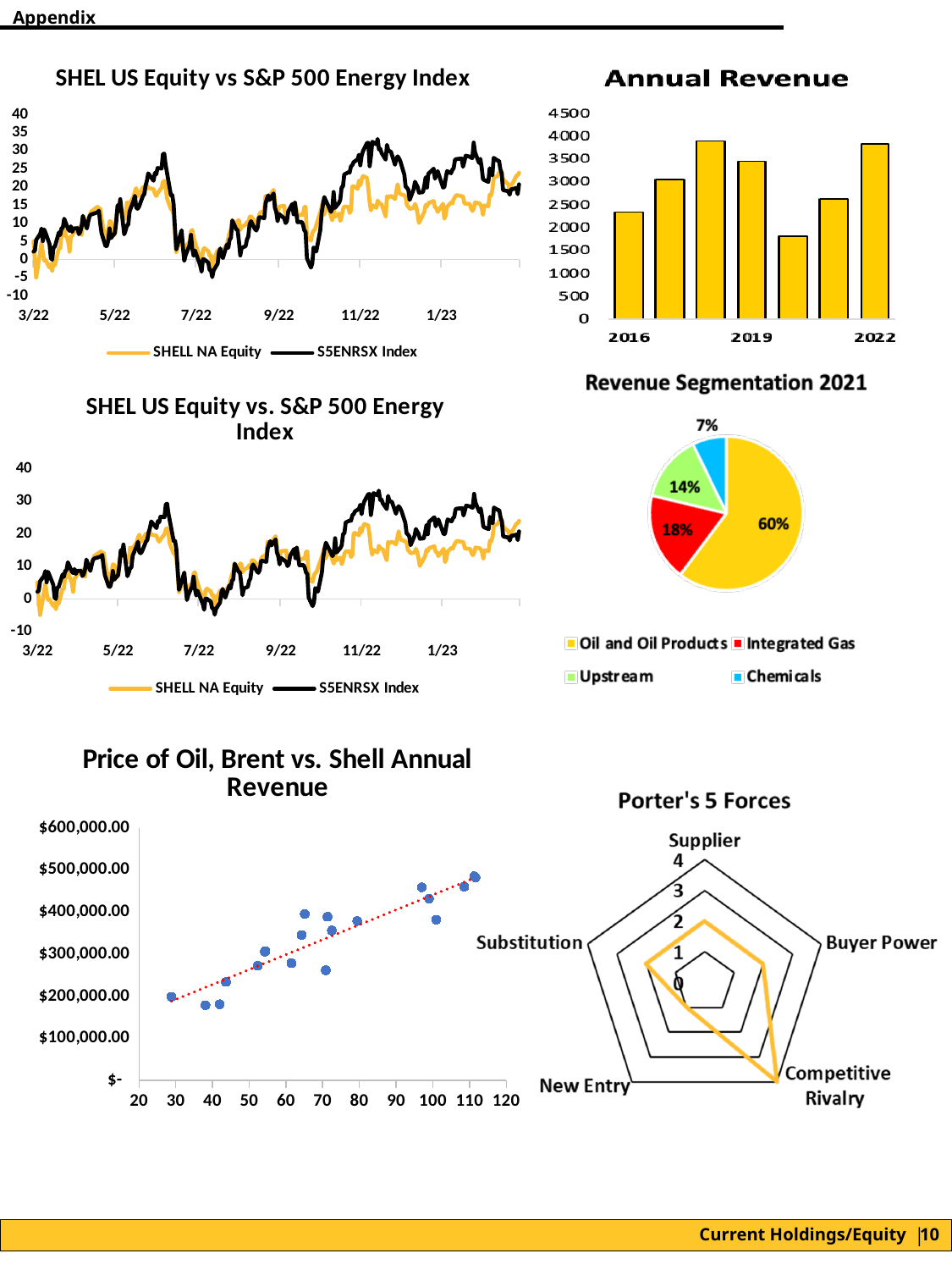
How many series does the legend of the top-left chart, SHEL US Equity vs S&P 500 Energy Index, list? 2 In the Annual Revenue bar chart, which is larger, the value for 2016 or the value for 2019? 2019 In the Porter's 5 Forces chart, what is the value for Competitive Rivalry? 4 In the Revenue Segmentation 2021 pie chart, what is the difference between the Oil and Oil Products share and the Integrated Gas share? 42% In the Revenue Segmentation 2021 pie chart, what share does Oil and Oil Products have? 60% What kind of chart is the Annual Revenue chart? bar chart In the Annual Revenue bar chart, is the value for 2022 greater or less than 3500? greater In the Annual Revenue bar chart, how many bars are shown? 7 How many segments does the Revenue Segmentation 2021 pie chart have? 4 In the Price of Oil, Brent vs. Shell Annual Revenue chart, do the points generally rise or fall as the x-axis value increases? rise In the Porter's 5 Forces chart, which force has the highest value? Competitive Rivalry In the Revenue Segmentation 2021 pie chart, which segment has the smallest share? Chemicals